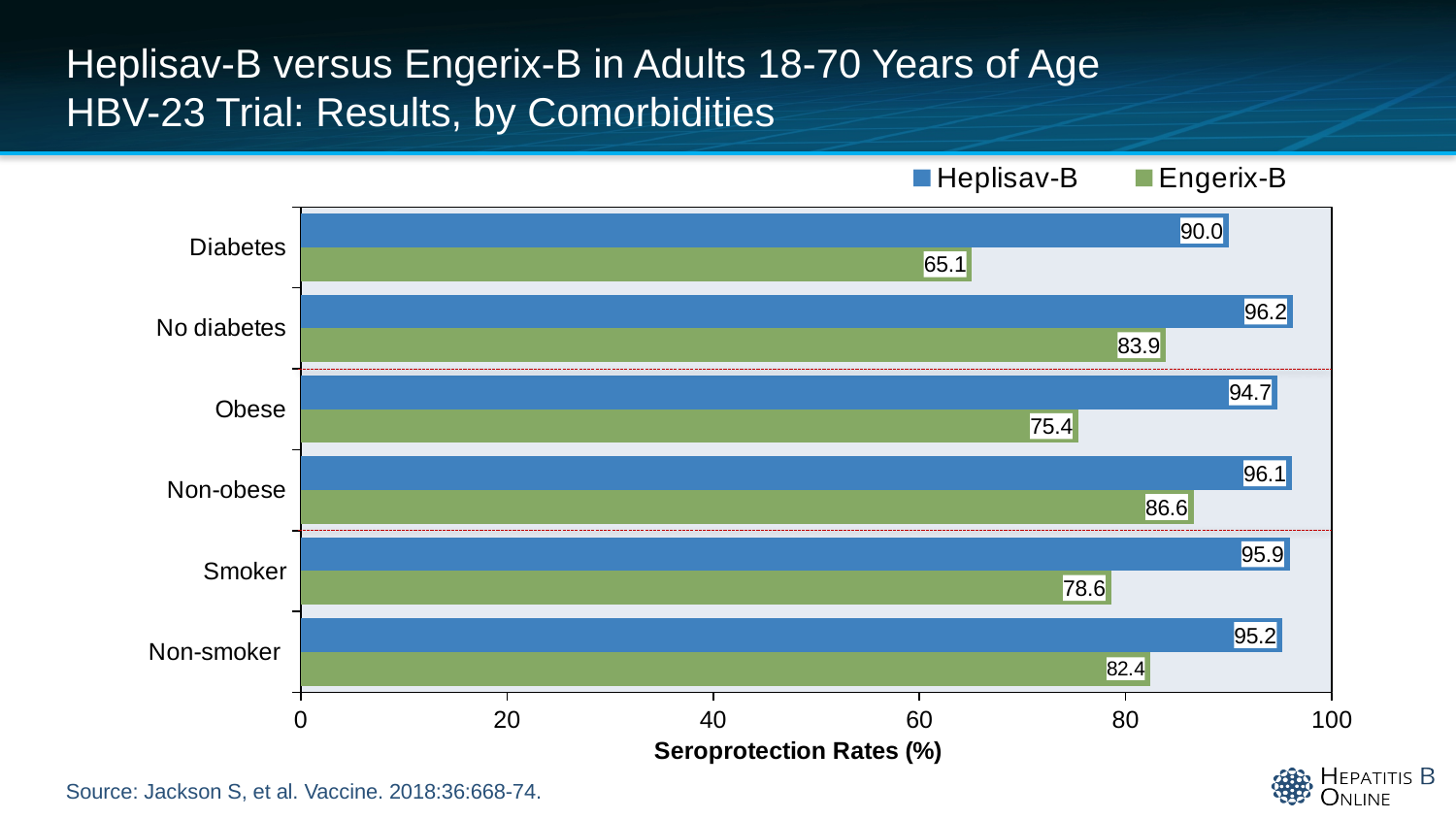
What is the Heplisav-B seroprotection rate for the Diabetes group? 90.0 What is the label of the x axis? Seroprotection Rates (%) Which category has the lowest Engerix-B seroprotection rate? Diabetes Which category has the highest Heplisav-B seroprotection rate? No diabetes How many comorbidity categories are shown on the chart? 6 What is the Engerix-B seroprotection rate for the Obese group? 75.4 What is the Engerix-B seroprotection rate for Non-smokers? 82.4 How many series does the legend list? 2 Which is larger, the Engerix-B rate for Smokers or for Non-smokers? Non-smoker What is the difference between the Heplisav-B and Engerix-B seroprotection rates for the Diabetes group? 24.9 What is the difference between the Engerix-B rates for Non-obese and Obese? 11.2 What type of chart is shown on the slide? Bar chart